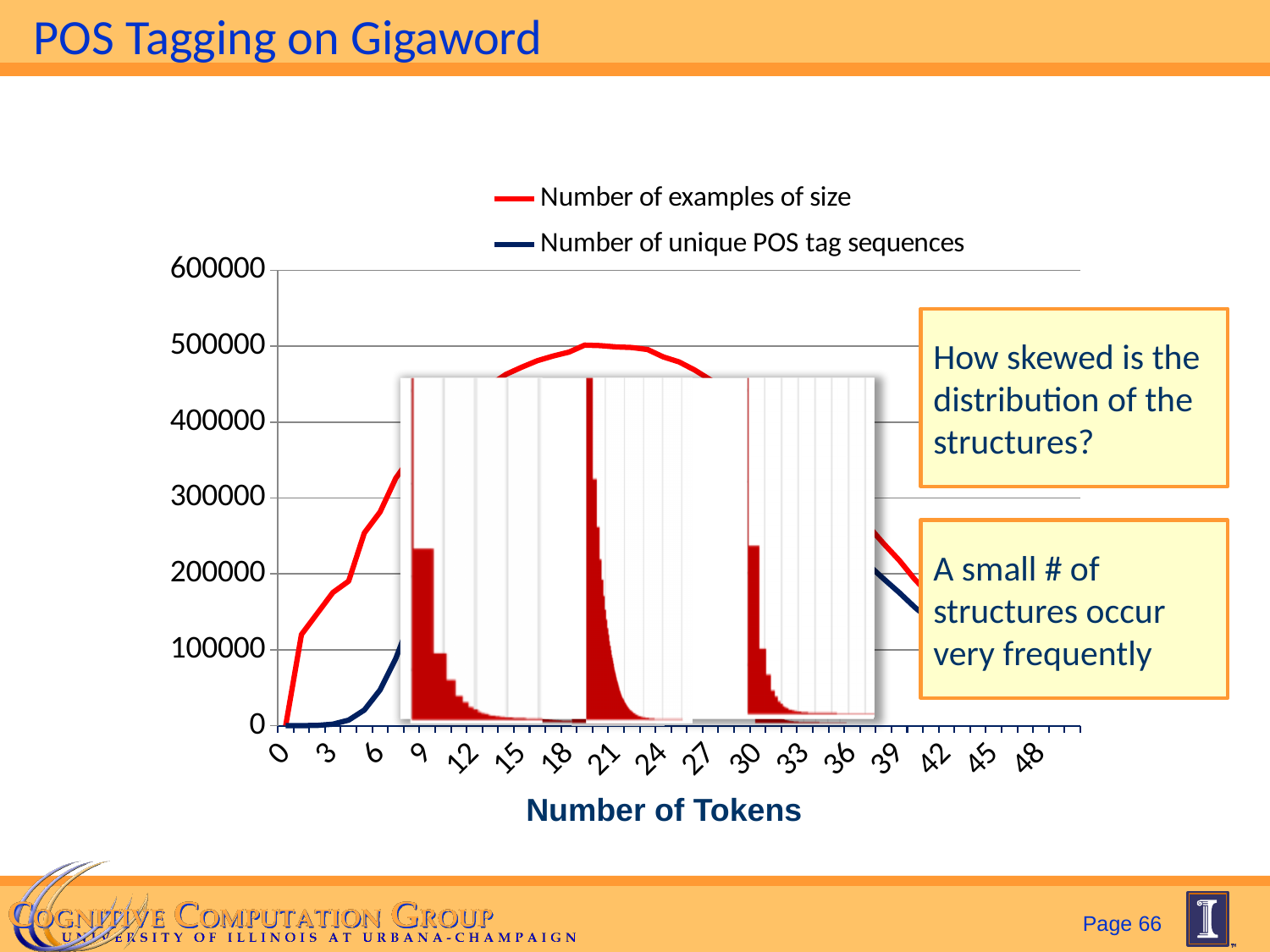
Is the peak value of 'Number of examples of size' greater or less than 400000? greater Is the value of 'Number of examples of size' at 3 tokens greater or less than 100000? greater What is the title of the x axis of the chart? Number of Tokens What kind of chart is shown on the slide? line chart What is the highest value labelled on the y axis of the chart? 600000 What is the last label on the x axis of the chart? 48 Is the value of 'Number of examples of size' at 6 tokens greater or less than 200000? greater How many series does the chart's legend list? 2 Which series is drawn in red in the chart? Number of examples of size At 6 tokens, which series has the larger value: 'Number of examples of size' or 'Number of unique POS tag sequences'? Number of examples of size Does 'Number of examples of size' rise or fall between 0 and 9 tokens? rise